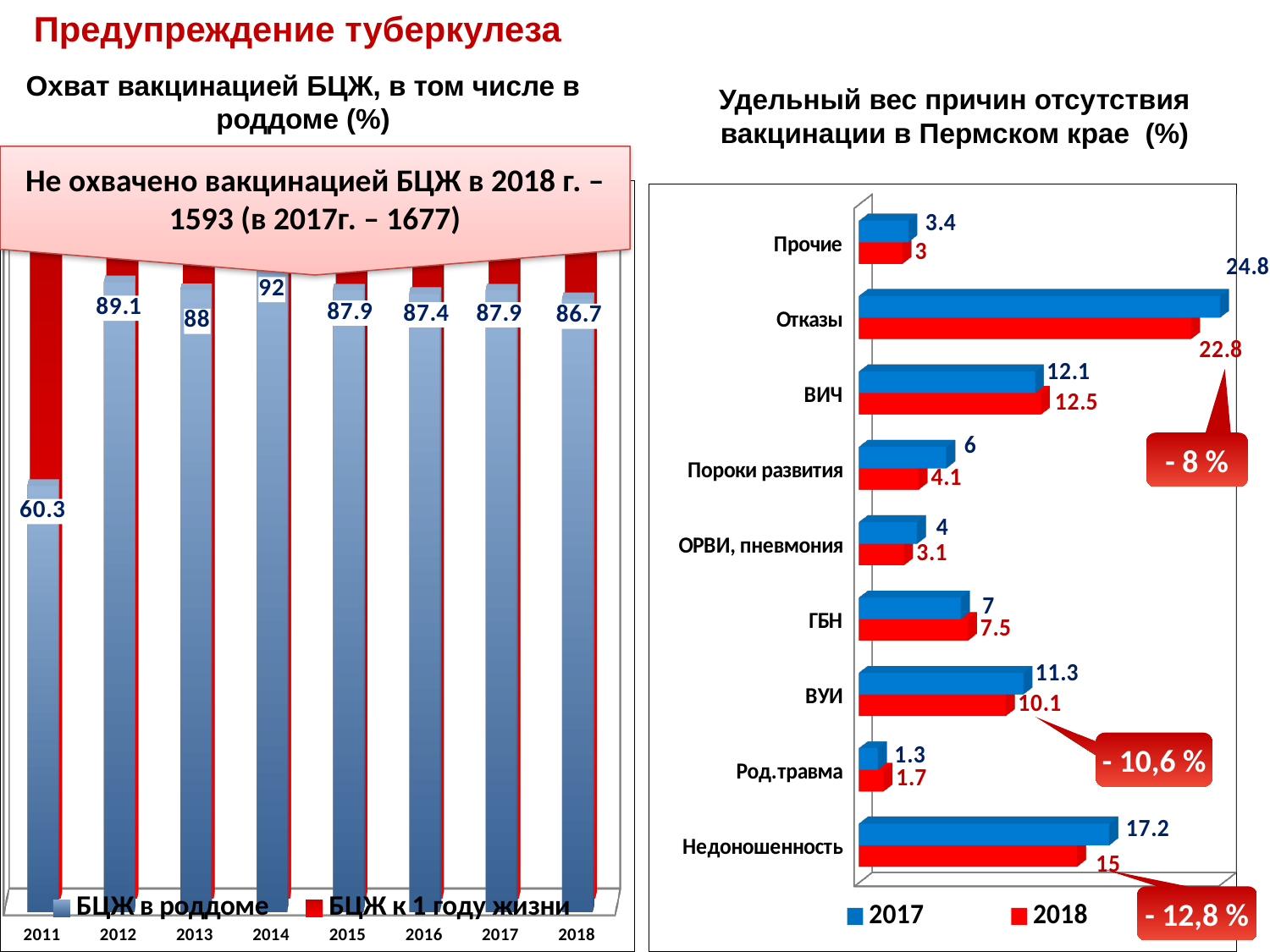
In the chart 'Охват вакцинацией БЦЖ, в том числе в роддоме (%)', how many series does the legend list? 2 In the chart 'Охват вакцинацией БЦЖ, в том числе в роддоме (%)', which year has the highest value for 'БЦЖ в роддоме'? 2014 In the chart 'Охват вакцинацией БЦЖ, в том числе в роддоме (%)', what is the value of 'БЦЖ в роддоме' for 2011? 60.3 In the chart 'Охват вакцинацией БЦЖ, в том числе в роддоме (%)', which year has the lowest value for 'БЦЖ в роддоме'? 2011 In the chart 'Охват вакцинацией БЦЖ, в том числе в роддоме (%)', what is the difference between the 'БЦЖ в роддоме' values for 2014 and 2018? 5.3 In the chart 'Охват вакцинацией БЦЖ, в том числе в роддоме (%)', how many years are shown on the x axis? 8 In the chart 'Удельный вес причин отсутствия вакцинации в Пермском крае (%)', which category has the highest 2017 value? Отказы In the chart 'Удельный вес причин отсутствия вакцинации в Пермском крае (%)', which is larger for 'ВИЧ': the 2017 value or the 2018 value? 2018 In the chart 'Удельный вес причин отсутствия вакцинации в Пермском крае (%)', what is the 2018 value for 'Отказы'? 22.8 In the chart 'Удельный вес причин отсутствия вакцинации в Пермском крае (%)', what is the difference between the 2017 and 2018 values for 'Недоношенность'? 2.2 In the chart 'Удельный вес причин отсутствия вакцинации в Пермском крае (%)', which category has the lowest 2018 value? Род.травма What kind of chart is 'Удельный вес причин отсутствия вакцинации в Пермском крае (%)'? Bar chart